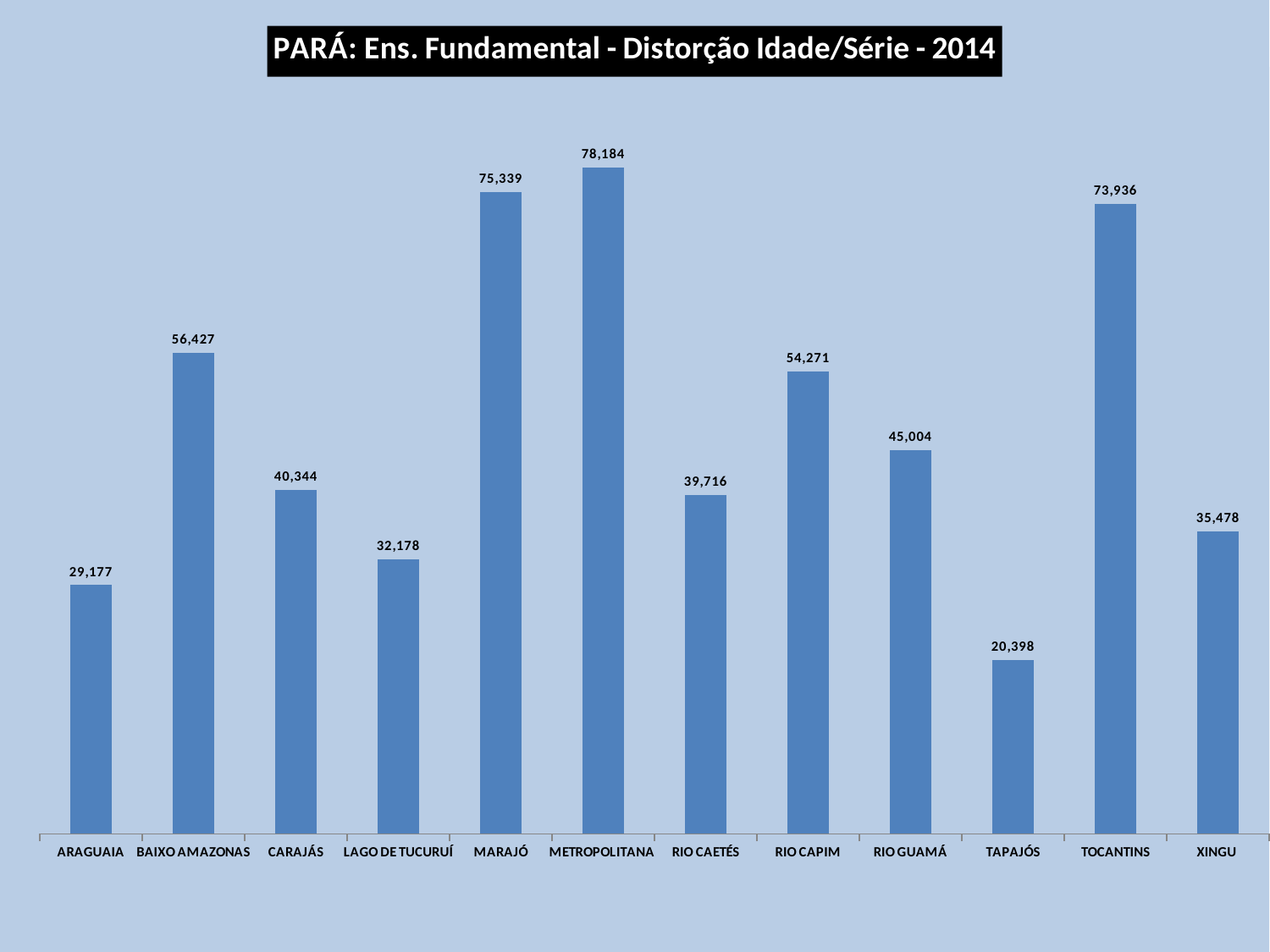
What is the title of the chart? PARÁ: Ens. Fundamental - Distorção Idade/Série - 2014 What is the difference between the values for RIO GUAMÁ and TAPAJÓS? 24,606 What is the value for RIO GUAMÁ? 45,004 What kind of chart is shown on the slide? Bar chart What is the value for MARAJÓ? 75,339 Which category has the highest value? METROPOLITANA Which category has the lowest value? TAPAJÓS How many categories are shown on the x axis? 12 What is the difference between the values for METROPOLITANA and MARAJÓ? 2,845 Which is larger, the value for BAIXO AMAZONAS or the value for RIO CAPIM? BAIXO AMAZONAS What is the value for LAGO DE TUCURUÍ? 32,178 What is the value for TAPAJÓS? 20,398